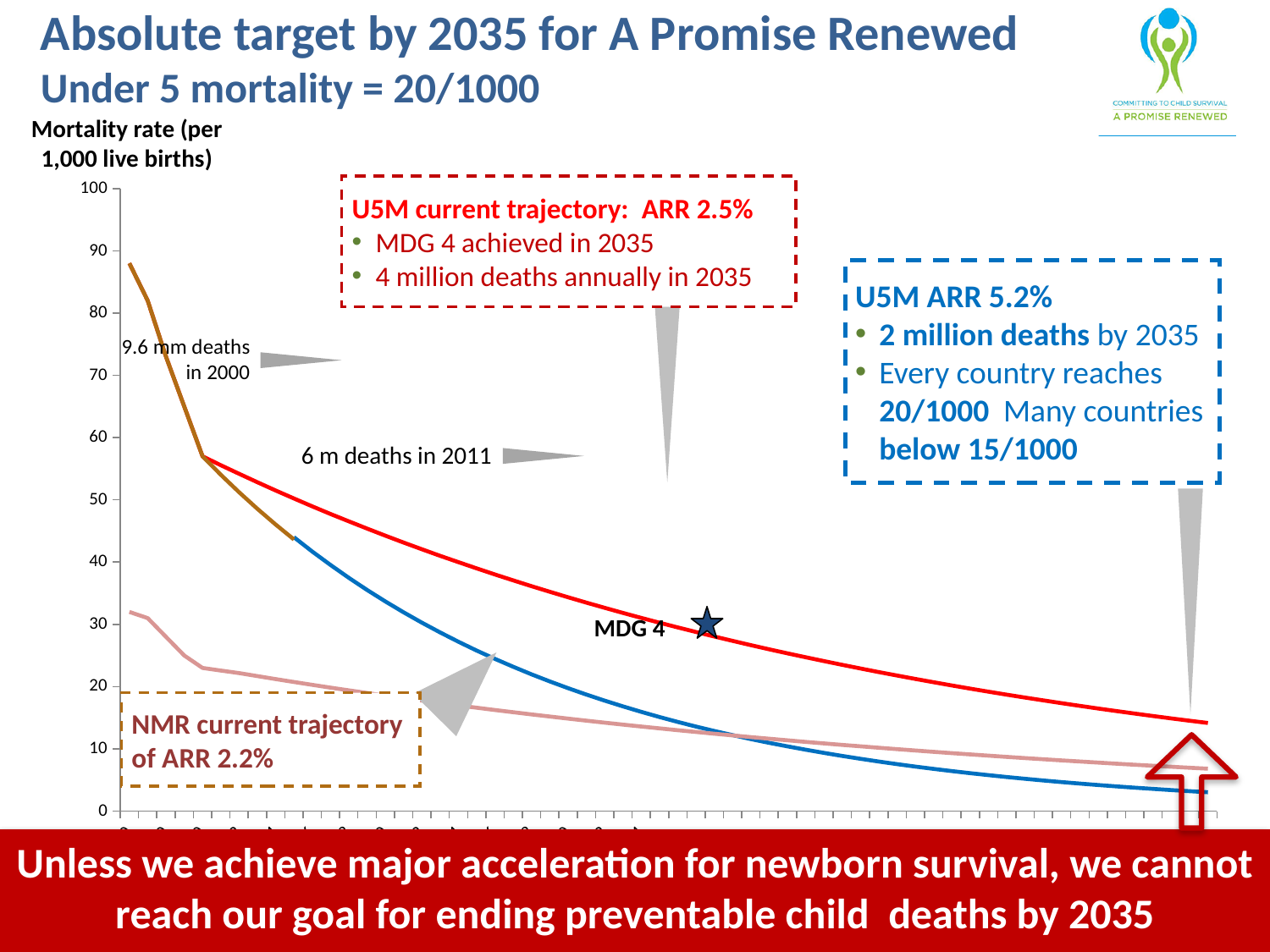
Is the value at the right end of the red U5M current trajectory line greater or less than 20? less At the right end of the chart, which line is higher: the red U5M current trajectory line or the blue U5M ARR 5.2% line? the red U5M current trajectory line Is the starting value of the pink NMR current trajectory line greater or less than 20? greater Is the value at the right end of the pink NMR current trajectory line greater or less than 10? less What is the highest value shown on the vertical axis of the chart? 100 What is the label of the vertical axis of the chart? Mortality rate (per 1,000 live births) What annual rate of reduction (ARR) is given for the U5M current trajectory? 2.5% Does the red U5M current trajectory line rise or fall from left to right? fall What annual rate of reduction (ARR) is given for the NMR current trajectory? 2.2% What kind of chart is shown on the slide? line chart